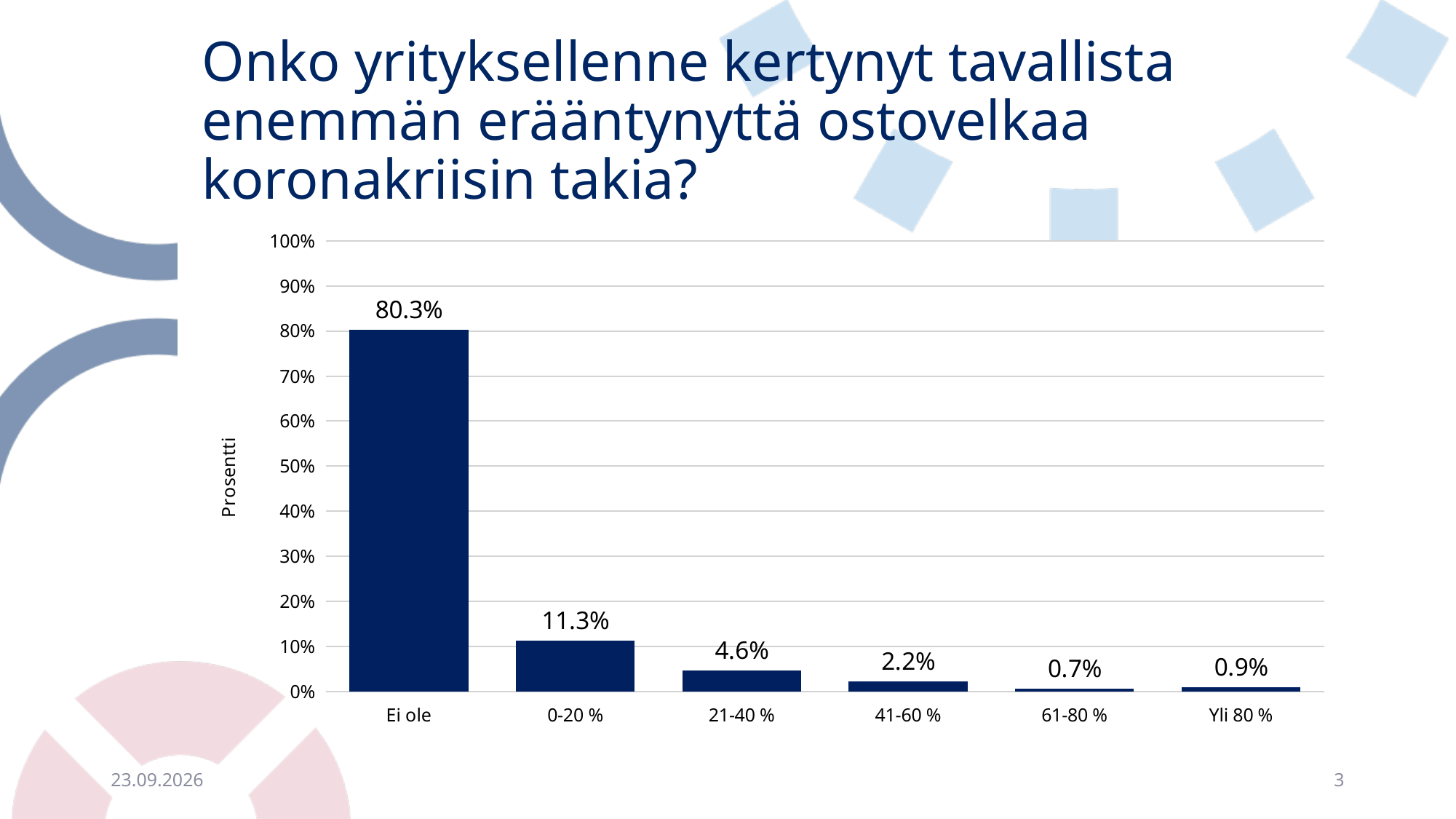
Which category has the lowest value? 61-80 % What is the label of the y axis? Prosentti Is the value for "0-20 %" greater or less than 10%? greater What kind of chart is shown on the slide? Bar chart What is the value for "21-40 %"? 4.6% Which category has the highest value? Ei ole How many categories are shown on the x axis? 6 What is the value for "Ei ole"? 80.3% Which is larger, the value for "41-60 %" or the value for "21-40 %"? 21-40 % What is the value for "Yli 80 %"? 0.9% What is the value for "0-20 %"? 11.3% What is the difference between the values for "Ei ole" and "0-20 %"? 69.0%